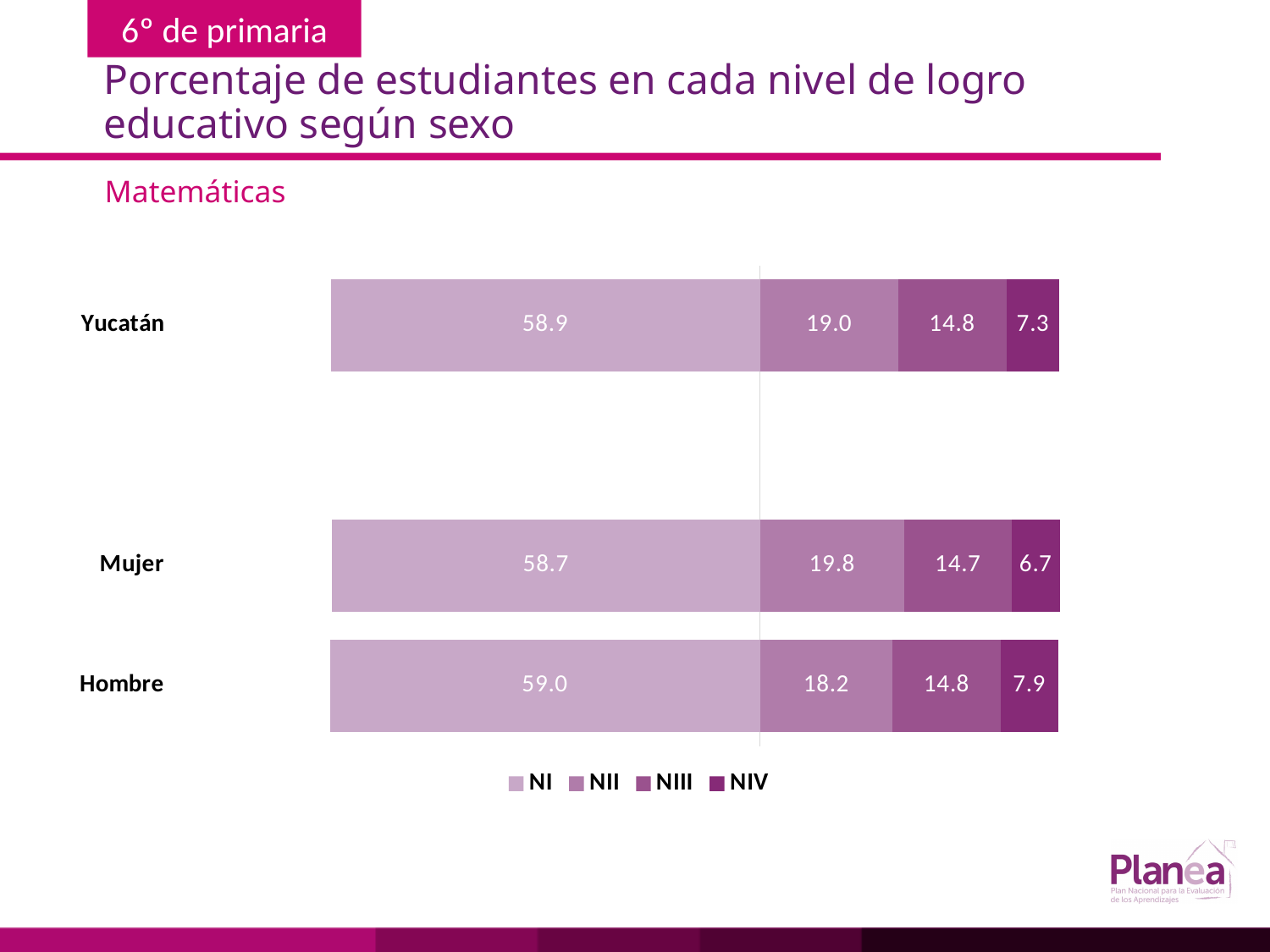
Which is larger, the NIV value for Hombre or for Mujer? Hombre What is the NIII value for Yucatán? 14.8 What kind of chart is shown on the slide? Stacked bar chart Which category has the lowest NIV value? Mujer What is the difference between the NII values for Mujer and Hombre? 1.6 What is the NII value for Mujer? 19.8 How many series does the legend list? 4 What is the NIV value for Hombre? 7.9 Which category has the highest NII value? Mujer What is the NI value for Yucatán? 58.9 How many categories are shown on the chart? 3 What is the total of the stacked bar for Hombre? 99.9